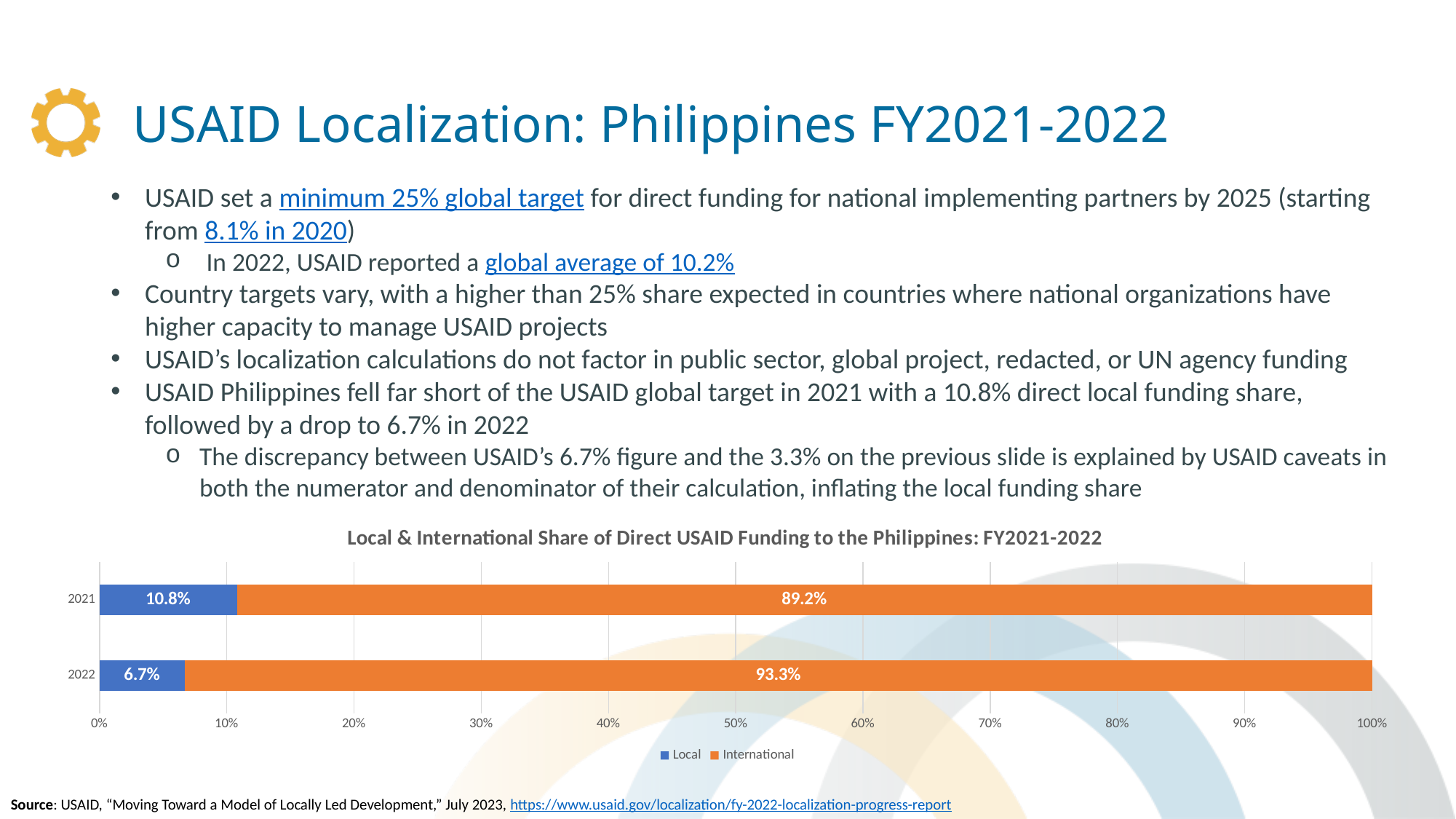
What is the International share in 2021? 89.2% Which year has the lower International share? 2021 Does the Local share rise or fall from 2021 to 2022? fall What is the Local share in 2022? 6.7% Is the Local share in 2021 larger or smaller than the Local share in 2022? larger How many series does the legend list? 2 How many years are shown in the chart? 2 By how many percentage points did the Local share fall from 2021 to 2022? 4.1 percentage points What is the Local share of direct USAID funding to the Philippines in 2021? 10.8% What is the International share of direct USAID funding to the Philippines in 2022? 93.3% What type of chart is shown on the slide? stacked bar chart Which year has the higher Local share? 2021